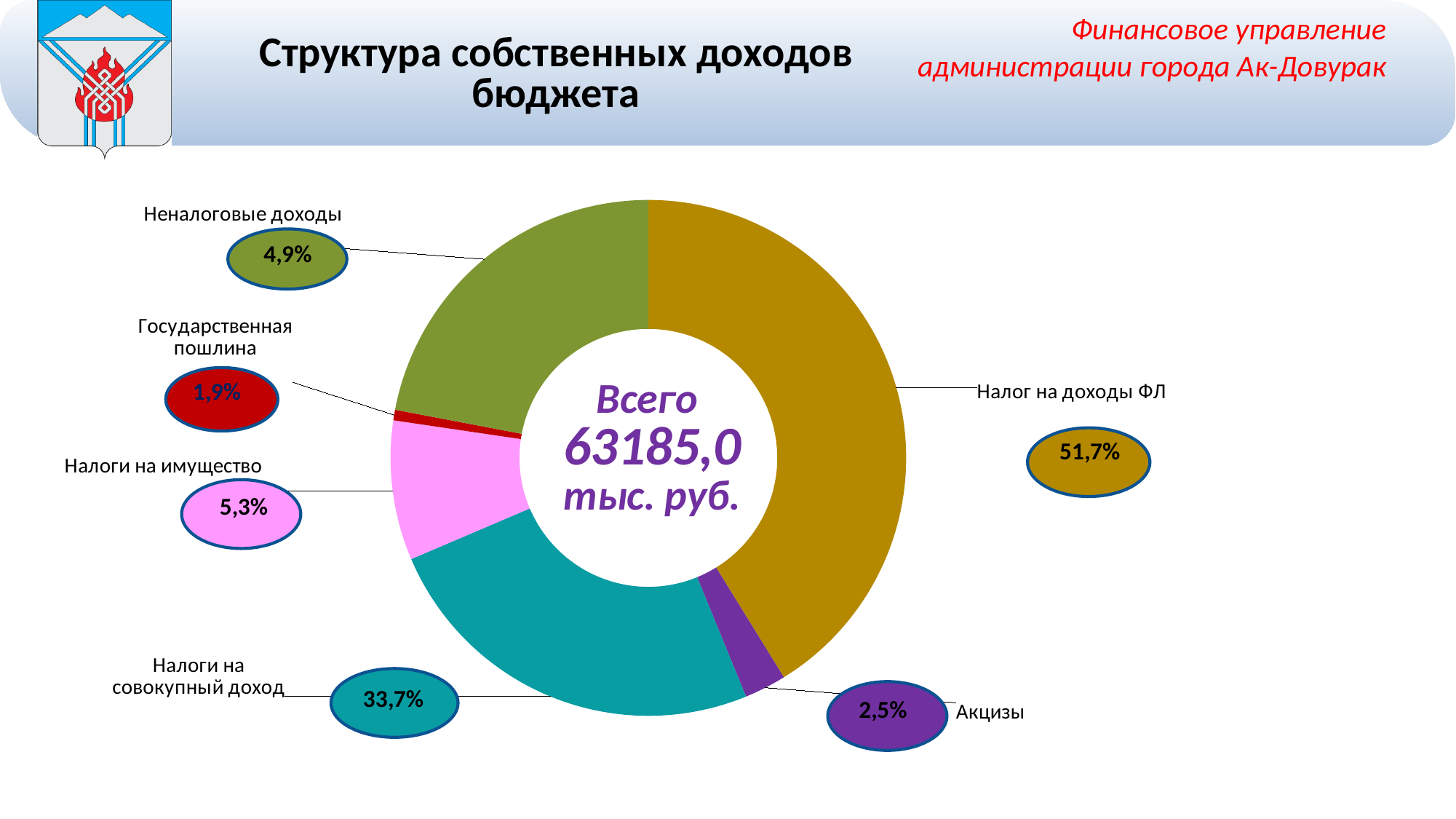
Which category has the smallest share of the chart? Государственная пошлина What share is shown for Налоги на совокупный доход? 33,7% What share of own budget revenues comes from Налог на доходы ФЛ? 51,7% What is the title of the slide? Структура собственных доходов бюджета What share is shown for Государственная пошлина? 1,9% What percentage is shown for Акцизы? 2,5% How many categories are shown in the chart? 6 What is the difference in percentage points between Налог на доходы ФЛ and Налоги на совокупный доход? 18,0 percentage points Which is larger: the share for Налоги на имущество or the share for Неналоговые доходы? Налоги на имущество What kind of chart is shown on the slide? Doughnut (pie) chart What total value is printed in the centre of the chart? 63185,0 тыс. руб. Which category has the largest share of the chart? Налог на доходы ФЛ